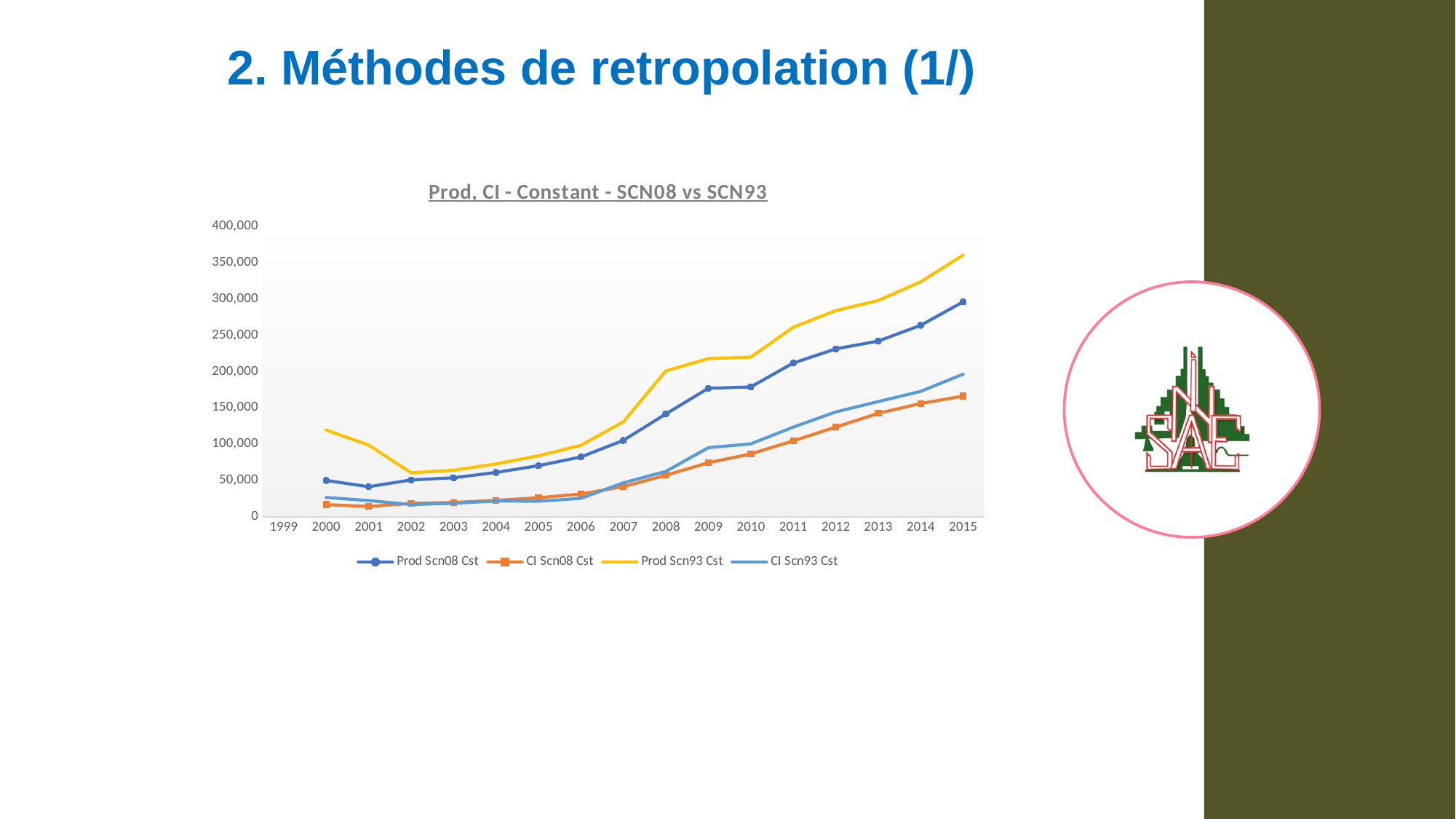
What is the title of the chart? Prod, CI - Constant - SCN08 vs SCN93 What kind of chart is shown on the slide? line chart In 2009, which is larger: CI Scn93 Cst or CI Scn08 Cst? CI Scn93 Cst Is the value for Prod Scn93 Cst in 2000 greater or less than 100,000? greater Does Prod Scn93 Cst rise or fall between 2000 and 2002? fall How many series does the legend list? 4 In which year does Prod Scn93 Cst reach its highest value? 2015 Is the value for Prod Scn93 Cst in 2015 greater or less than 300,000? greater In which year is Prod Scn08 Cst at its lowest? 2001 Which series has the highest value in 2015? Prod Scn93 Cst Which series has the lowest value in 2015? CI Scn08 Cst Is the value for CI Scn08 Cst in 2000 greater or less than 50,000? less